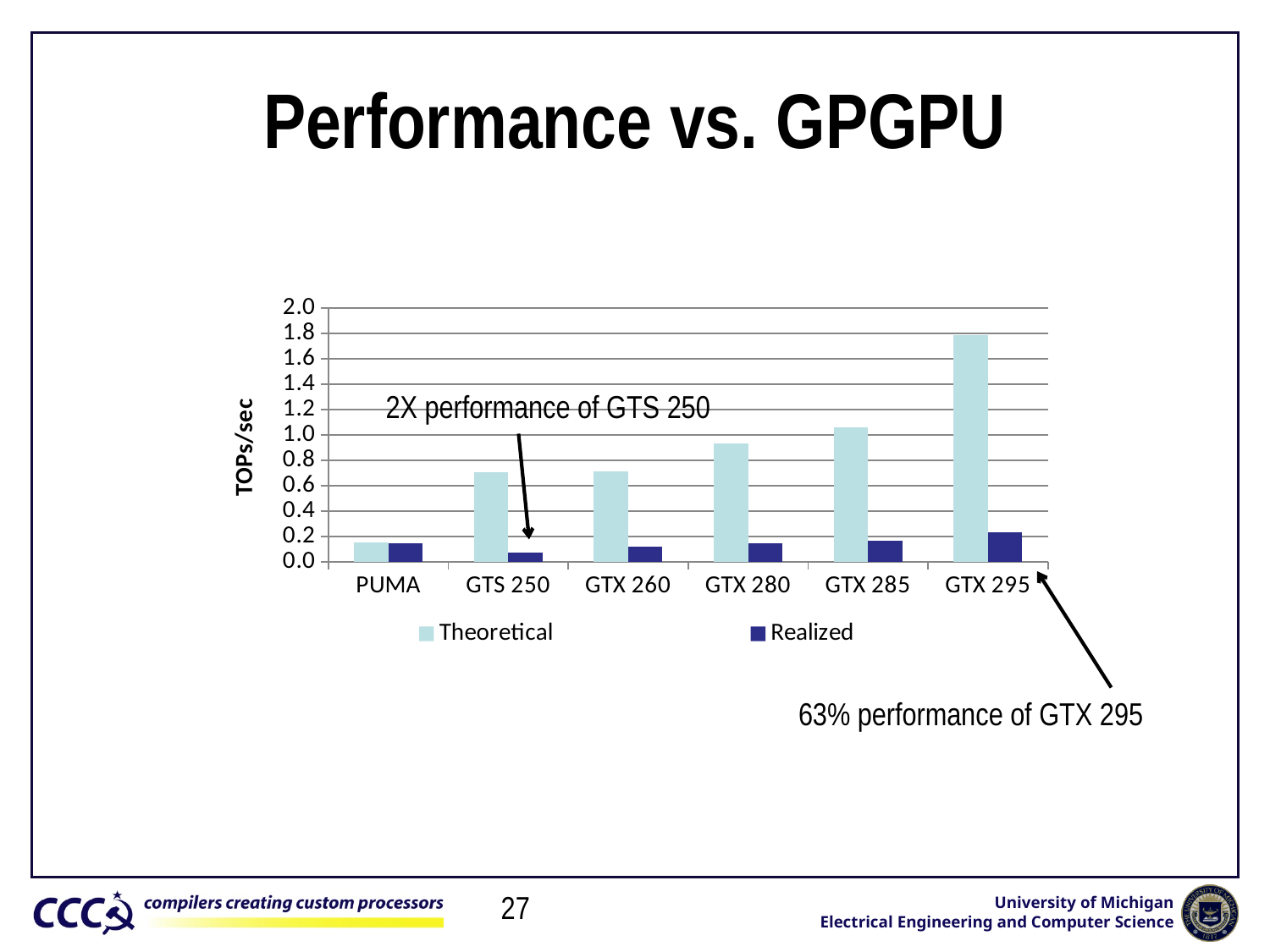
How many categories are shown on the x axis? 6 Which is larger, the Theoretical value for GTX 285 or the Theoretical value for GTX 295? GTX 295 What kind of chart is shown on the slide? bar chart How many series does the legend list? 2 Is the Theoretical value for PUMA greater or less than 0.2? less What is the label on the y axis? TOPs/sec Do the Theoretical values rise or fall moving from PUMA to GTX 295 along the x axis? rise Is the Theoretical value for GTX 295 greater or less than 1.6? greater Which category has the lowest Theoretical value? PUMA Is the Theoretical value for GTX 280 greater or less than 1.0? less Which category has the highest Theoretical value? GTX 295 Which category has the lowest Realized value? GTS 250